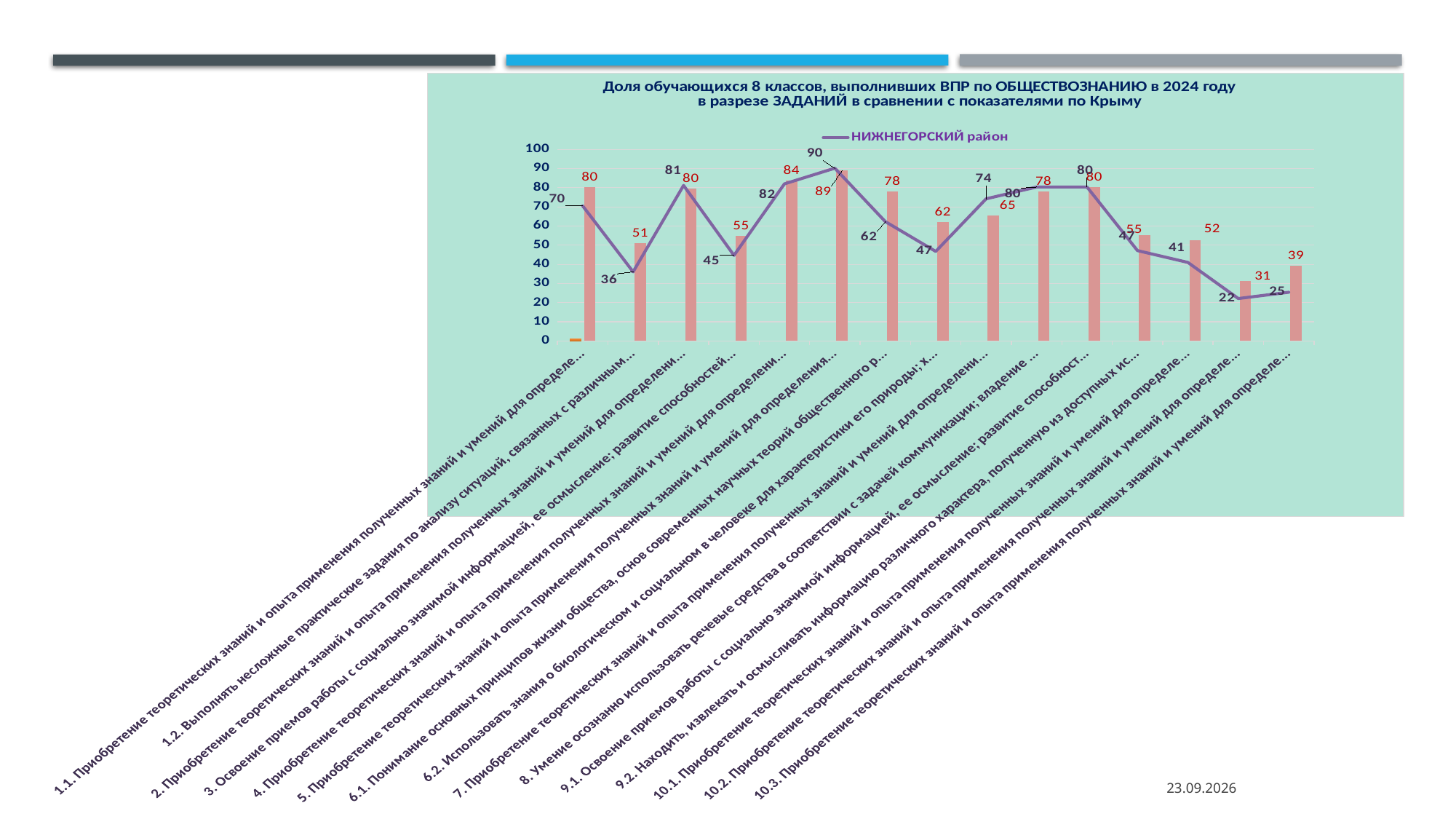
What is the value of the НИЖНЕГОРСКИЙ район line for task 5 (Приобретение теоретических знаний и опыта применения полученных знаний и умений для определения...)? 90 How many tasks (categories) are shown on the x axis of the chart? 15 For which task does the НИЖНЕГОРСКИЙ район line have its lowest value? Task 10.2 (22) What is the value of the bar for task 1.2 (Выполнять несложные практические задания по анализу ситуаций...)? 51 For task 7, which is larger: the bar value or the НИЖНЕГОРСКИЙ район line value? The НИЖНЕГОРСКИЙ район line value (74 vs 65) What kind of chart is shown on the slide? A combined bar and line chart For task 1.1, what is the difference between the bar value (80) and the НИЖНЕГОРСКИЙ район line value (70)? 10 For which task does the НИЖНЕГОРСКИЙ район line reach its highest value? Task 5 (90) Does the НИЖНЕГОРСКИЙ район line rise or fall from task 9.1 to task 10.2? Fall How many series does the chart legend list? 1 What is the name of the series shown in the chart legend? НИЖНЕГОРСКИЙ район What is the value of the НИЖНЕГОРСКИЙ район line for task 10.3? 25